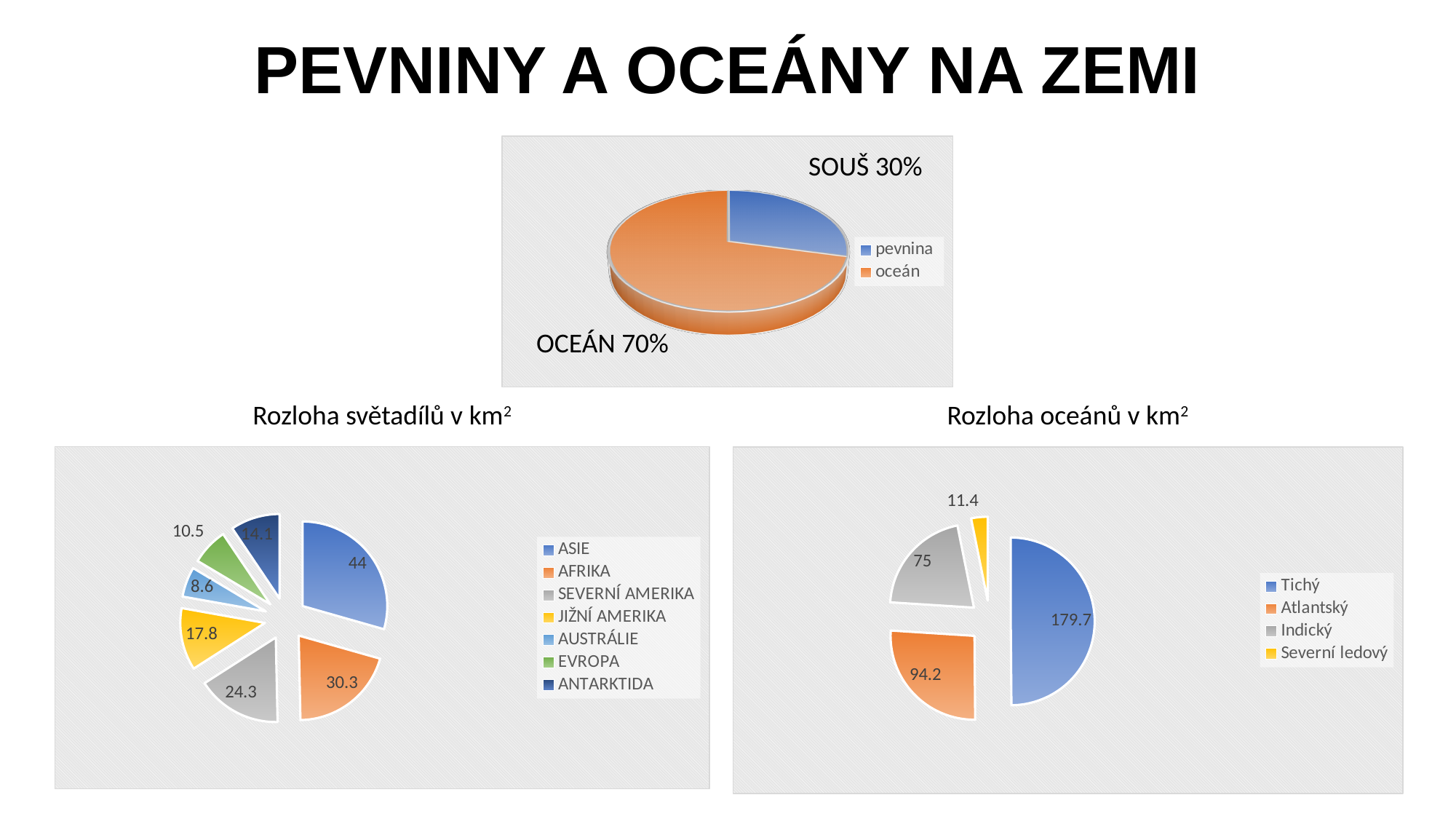
In the top pie chart, what percentage is labelled for OCEÁN? 70% In the chart 'Rozloha oceánů v km²', which ocean has the largest value? Tichý In the chart 'Rozloha světadílů v km²', what is the value for AUSTRÁLIE? 8.6 In the chart 'Rozloha oceánů v km²', which is larger, Indický or Severní ledový? Indický In the chart 'Rozloha světadílů v km²', which continent has the smallest value? AUSTRÁLIE In the chart 'Rozloha oceánů v km²', what is the value for Atlantský? 94.2 What type of chart is 'Rozloha oceánů v km²'? Pie chart In the top pie chart, what percentage is labelled for SOUŠ? 30% How many series does the legend of the top pie chart list? 2 In the chart 'Rozloha světadílů v km²', what is the difference between the values for AFRIKA and SEVERNÍ AMERIKA? 6 In the chart 'Rozloha světadílů v km²', how many slices does the pie have? 7 In the chart 'Rozloha světadílů v km²', what is the value for ASIE? 44